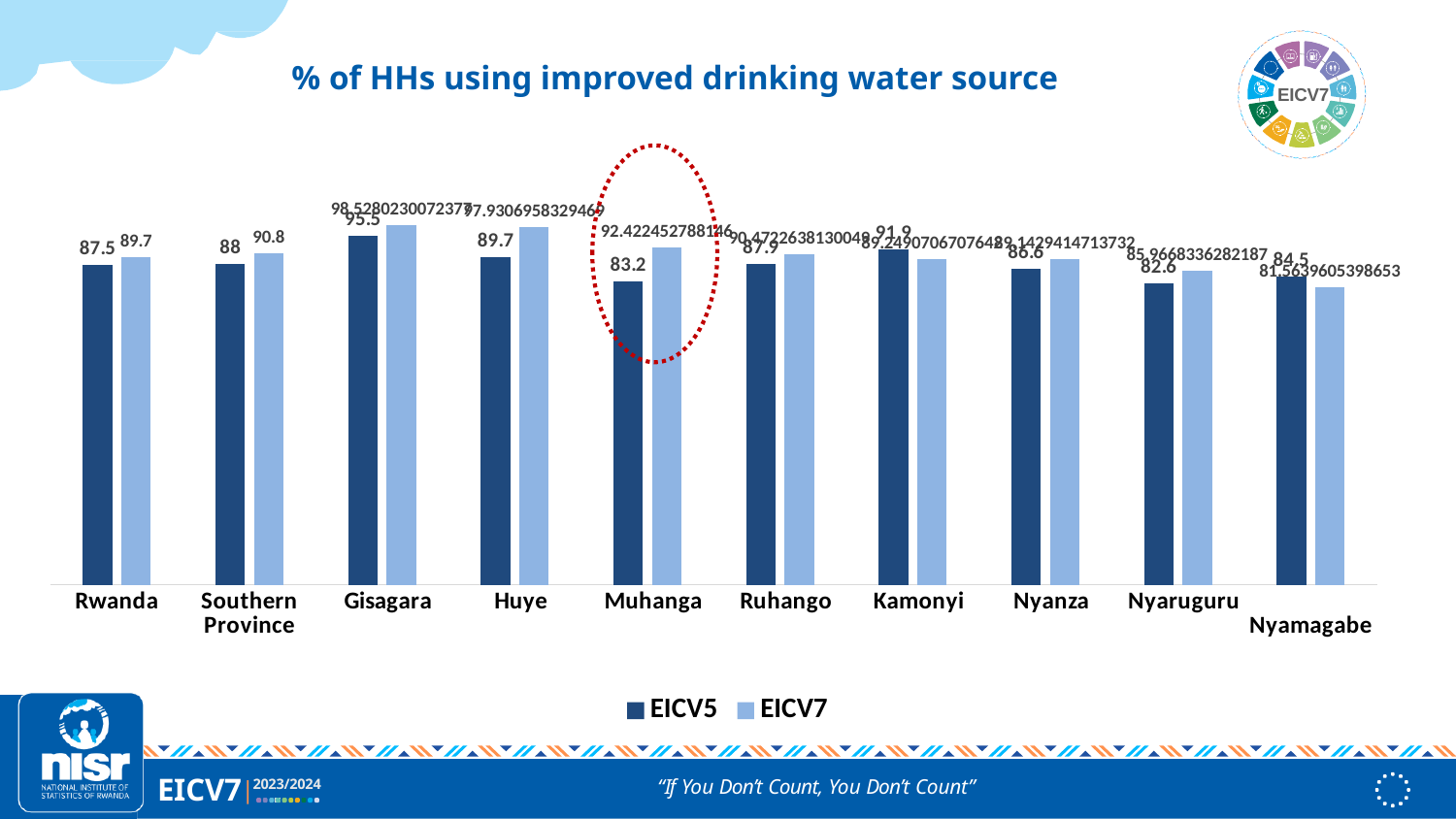
Which category's bars are highlighted with a red dotted circle? Muhanga What is the EICV5 value for Rwanda? 87.5 What is the EICV7 value for Southern Province? 90.8 For Nyamagabe, which is larger: the EICV5 value or the EICV7 value? EICV5 What is the EICV5 value for Muhanga? 83.2 Which category has the highest EICV5 value? Gisagara What is the difference between the EICV7 and EICV5 values for Rwanda? 2.2 How many series does the legend list? 2 What is the EICV5 value for Kamonyi? 91.9 How many categories are shown on the x axis? 10 Which category has the lowest EICV5 value? Nyaruguru What kind of chart is shown on the slide? Bar chart